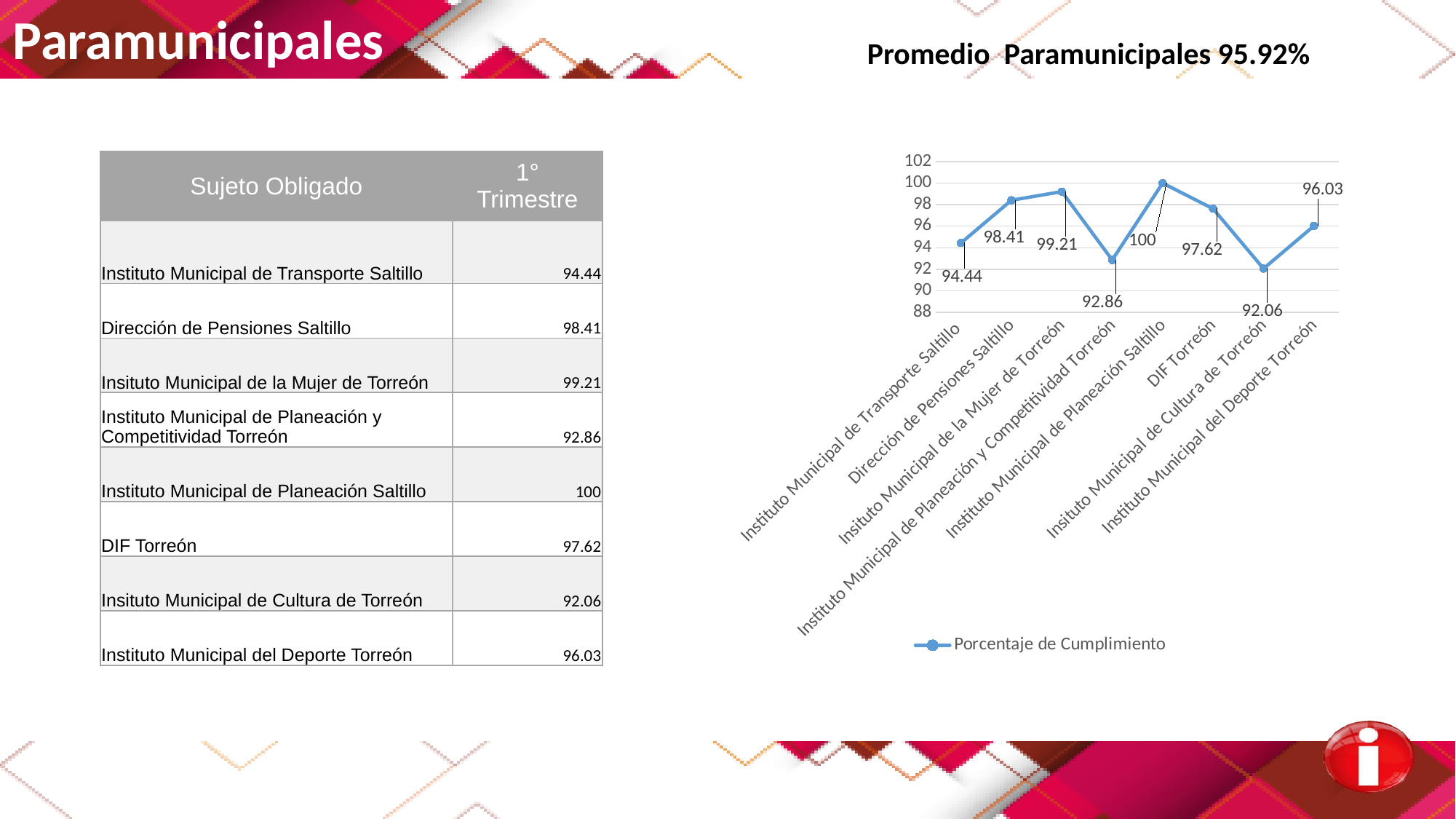
What type of chart is shown on the slide? line chart Is the value for Instituto Municipal de Planeación y Competitividad Torreón greater or less than 94? less Which category has the lowest Porcentaje de Cumplimiento? Insituto Municipal de Cultura de Torreón What is the Porcentaje de Cumplimiento for Instituto Municipal de Transporte Saltillo? 94.44 How many series does the chart legend list? 1 Which has a higher Porcentaje de Cumplimiento, Insituto Municipal de la Mujer de Torreón or DIF Torreón? Insituto Municipal de la Mujer de Torreón What is the Porcentaje de Cumplimiento for DIF Torreón? 97.62 What is the difference between the values for Dirección de Pensiones Saltillo and Instituto Municipal de Transporte Saltillo? 3.97 Which category has the highest Porcentaje de Cumplimiento? Instituto Municipal de Planeación Saltillo What is the name of the series shown in the chart legend? Porcentaje de Cumplimiento How many categories are plotted on the x axis of the chart? 8 What is the Porcentaje de Cumplimiento for Instituto Municipal del Deporte Torreón? 96.03